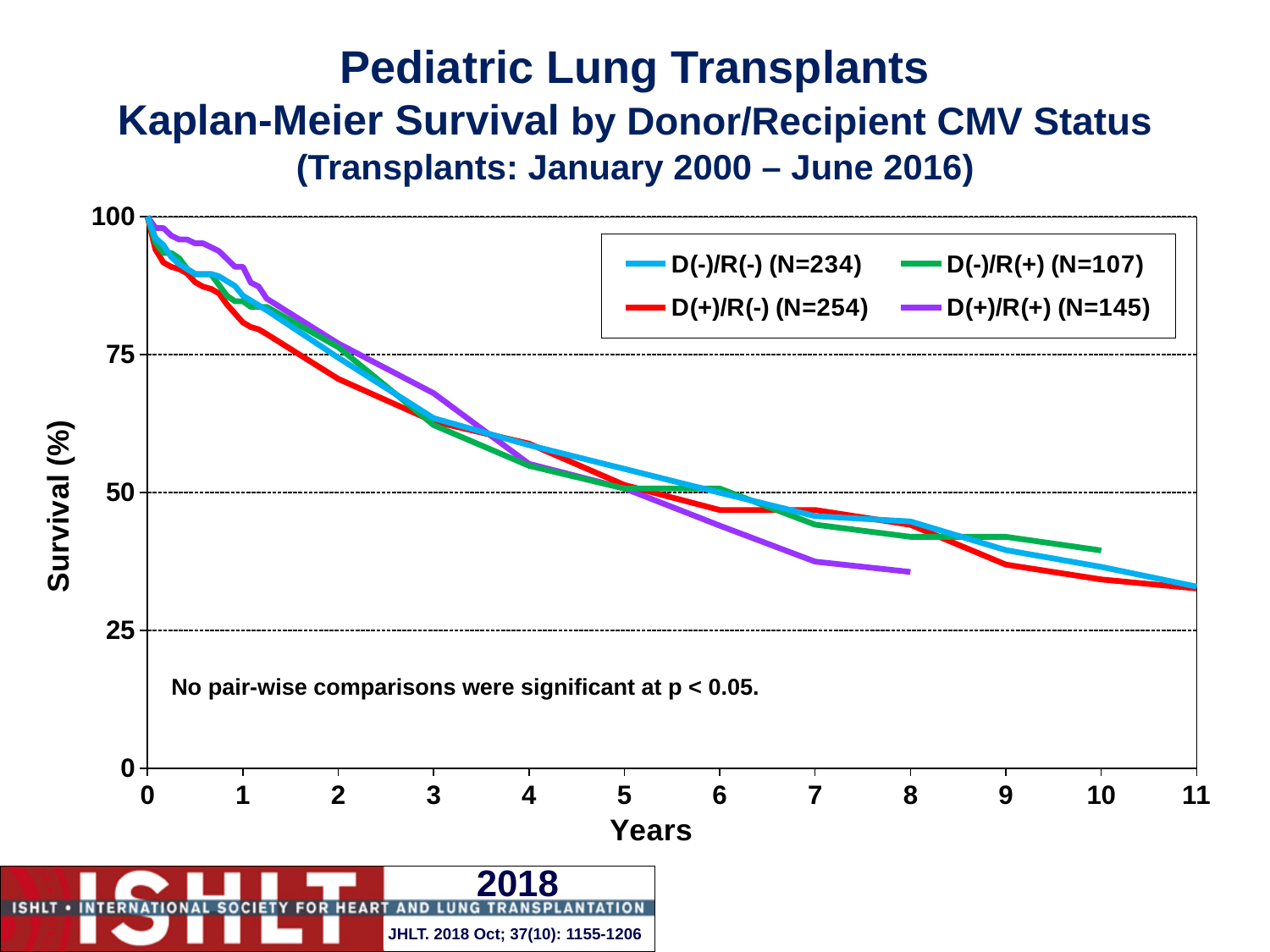
What is the N for the D(+)/R(-) group shown in the legend? 254 Is the survival value for D(+)/R(+) at 8 years greater or less than 50? less Which group has the smallest N in the legend? D(-)/R(+) (N=107) Is the survival value for D(-)/R(+) at 10 years greater or less than 50? less Is the survival value for D(-)/R(-) at 1 year greater or less than 75? greater What is the N for the D(-)/R(-) group shown in the legend? 234 What is the label of the y axis? Survival (%) Which group has the largest N in the legend? D(+)/R(-) (N=254) How many series does the legend list? 4 Do the survival curves rise or fall as years increase? fall What kind of chart is shown on the slide? line chart At 7 years, which group has higher survival: D(-)/R(-) or D(+)/R(+)? D(-)/R(-)